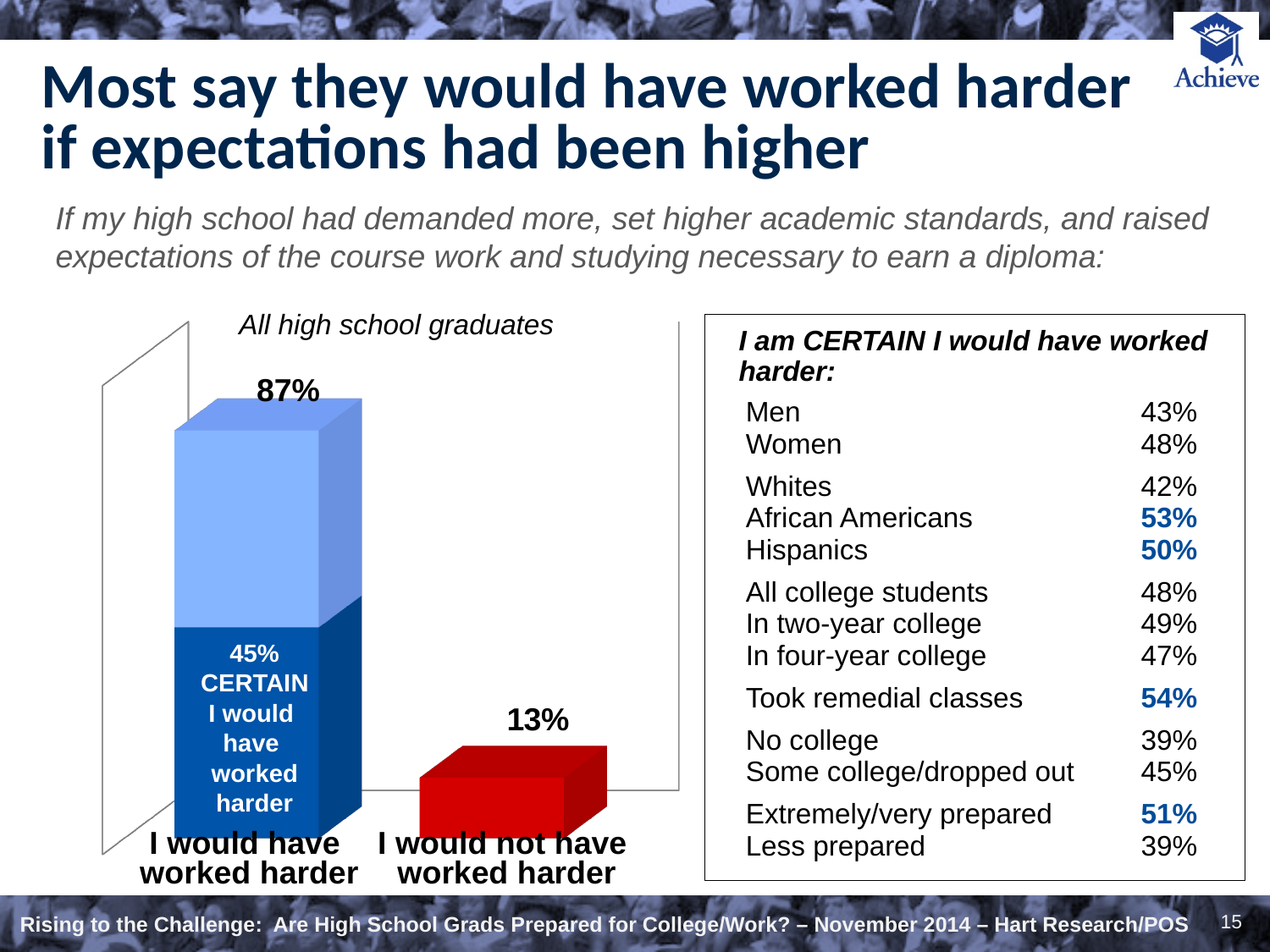
How many bars are shown in the chart? 2 Which bar in the chart is the shortest? I would not have worked harder What is the difference between the share who would have worked harder and the share who would not have? 74 percentage points What type of chart is shown on the slide? Bar chart Which is larger: the share who would have worked harder or the share who would not have worked harder? I would have worked harder What percentage of all high school graduates say they would have worked harder? 87% What is the title shown above the chart? All high school graduates What colour is the bar for "I would not have worked harder"? Red What is the difference between the total share who would have worked harder and the share who are CERTAIN they would have? 42 percentage points What percentage of all high school graduates are CERTAIN they would have worked harder? 45% What percentage of all high school graduates say they would not have worked harder? 13% Which bar in the chart is the tallest? I would have worked harder